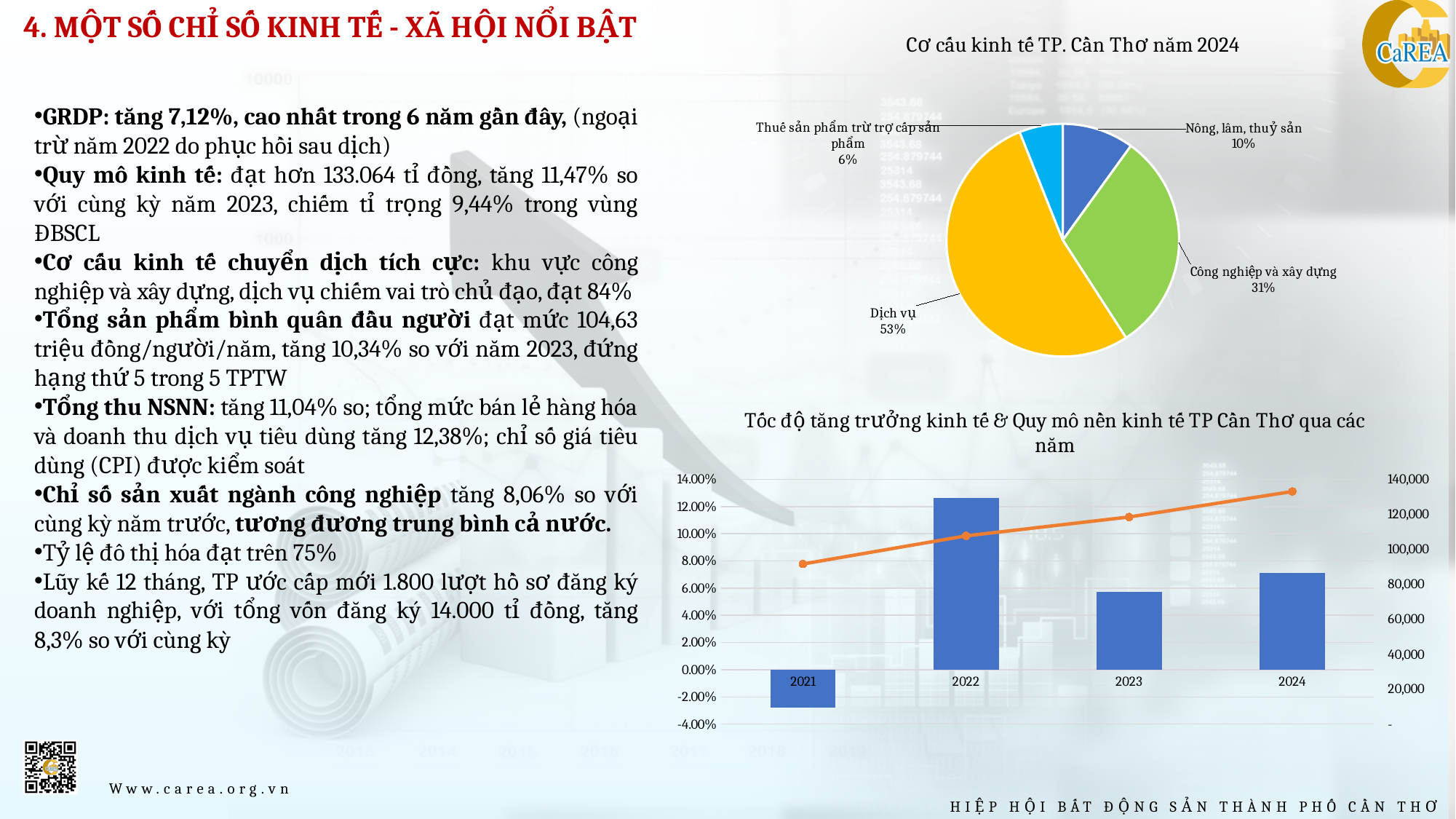
In the pie chart 'Cơ cấu kinh tế TP. Cần Thơ năm 2024', how many percentage points larger is 'Dịch vụ' than 'Công nghiệp và xây dựng'? 22 percentage points In the chart 'Tốc độ tăng trưởng kinh tế & Quy mô nền kinh tế TP Cần Thơ qua các năm', which year has the tallest bar? 2022 In the chart 'Tốc độ tăng trưởng kinh tế & Quy mô nền kinh tế TP Cần Thơ qua các năm', how many years are shown on the x axis? 4 What kind of chart is 'Cơ cấu kinh tế TP. Cần Thơ năm 2024'? Pie chart In the pie chart 'Cơ cấu kinh tế TP. Cần Thơ năm 2024', what share does 'Dịch vụ' have? 53% In the pie chart 'Cơ cấu kinh tế TP. Cần Thơ năm 2024', what share does 'Công nghiệp và xây dựng' have? 31% In the chart 'Tốc độ tăng trưởng kinh tế & Quy mô nền kinh tế TP Cần Thơ qua các năm', is the bar for 2022 greater or less than 10.00%? greater In the chart 'Tốc độ tăng trưởng kinh tế & Quy mô nền kinh tế TP Cần Thơ qua các năm', does the orange line rise or fall from 2021 to 2024? Rises In the pie chart 'Cơ cấu kinh tế TP. Cần Thơ năm 2024', what share does 'Nông, lâm, thuỷ sản' have? 10% In the pie chart 'Cơ cấu kinh tế TP. Cần Thơ năm 2024', which sector has the largest share? Dịch vụ How many slices does the pie chart 'Cơ cấu kinh tế TP. Cần Thơ năm 2024' have? 4 In the pie chart 'Cơ cấu kinh tế TP. Cần Thơ năm 2024', which sector has the smallest share? Thuế sản phẩm trừ trợ cấp sản phẩm